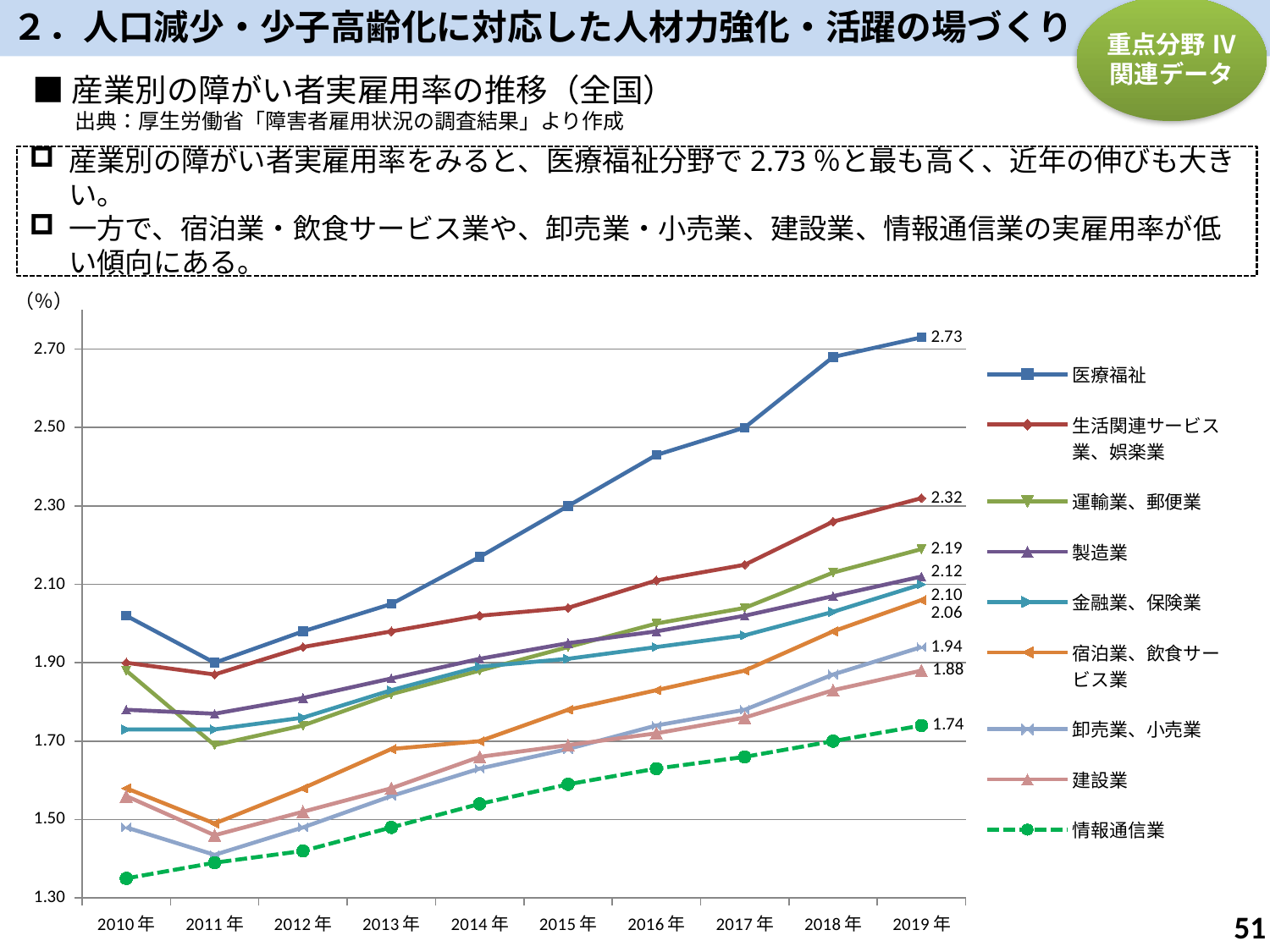
Is the value for 情報通信業 in 2010 greater or less than 1.50? less How many series does the legend list? 9 Which industry has the highest employment rate in 2019? 医療福祉 Is the value for 医療福祉 in 2010 greater or less than 1.90? greater How many years are shown on the x axis? 10 In 2019, which is larger: 製造業 or 建設業? 製造業 Which industry has the lowest employment rate in 2019? 情報通信業 What kind of chart is shown on the slide? line chart What is the 2019 value for 運輸業、郵便業? 2.19 What is the 2019 value for 情報通信業? 1.74 What is the 2019 value for 医療福祉? 2.73 What is the difference between the 2019 values for 医療福祉 and 生活関連サービス業、娯楽業? 0.41